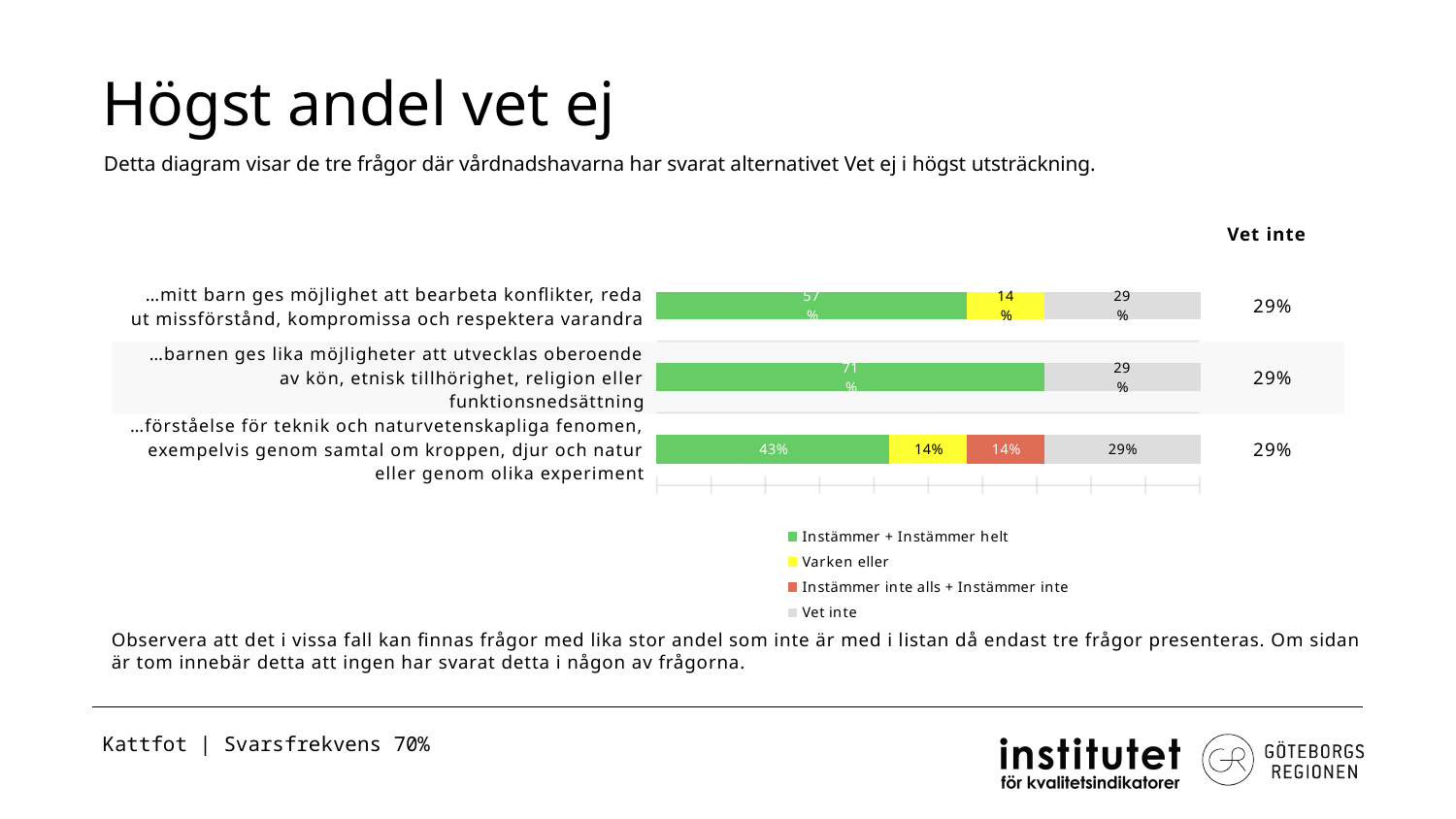
What is the title of the slide containing the chart? Högst andel vet ej How many categories (questions) are plotted in the chart? 3 Which category has the lowest value for "Instämmer + Instämmer helt"? …förståelse för teknik och naturvetenskapliga fenomen, exempelvis genom samtal om kroppen, djur och natur eller genom olika experiment What is the value of "Instämmer inte alls + Instämmer inte" for the category "…förståelse för teknik och naturvetenskapliga fenomen, exempelvis genom samtal om kroppen, djur och natur eller genom olika experiment"? 14% What is the value of "Instämmer + Instämmer helt" for the category "…barnen ges lika möjligheter att utvecklas oberoende av kön, etnisk tillhörighet, religion eller funktionsnedsättning"? 71% What is the "Vet inte" value for the category "…mitt barn ges möjlighet att bearbeta konflikter, reda ut missförstånd, kompromissa och respektera varandra"? 29% Which is larger: the "Instämmer + Instämmer helt" value for "…mitt barn ges möjlighet att bearbeta konflikter, reda ut missförstånd, kompromissa och respektera varandra" or for "…förståelse för teknik och naturvetenskapliga fenomen, exempelvis genom samtal om kroppen, djur och natur eller genom olika experiment"? …mitt barn ges möjlighet att bearbeta konflikter, reda ut missförstånd, kompromissa och respektera varandra How many series does the chart legend list? 4 Which category has the highest value for "Instämmer + Instämmer helt"? …barnen ges lika möjligheter att utvecklas oberoende av kön, etnisk tillhörighet, religion eller funktionsnedsättning What is the value of "Instämmer + Instämmer helt" for the category "…förståelse för teknik och naturvetenskapliga fenomen, exempelvis genom samtal om kroppen, djur och natur eller genom olika experiment"? 43% What kind of chart is shown on the slide? bar chart What is the difference between the "Instämmer + Instämmer helt" values for "…barnen ges lika möjligheter att utvecklas oberoende av kön, etnisk tillhörighet, religion eller funktionsnedsättning" and "…mitt barn ges möjlighet att bearbeta konflikter, reda ut missförstånd, kompromissa och respektera varandra"? 14%